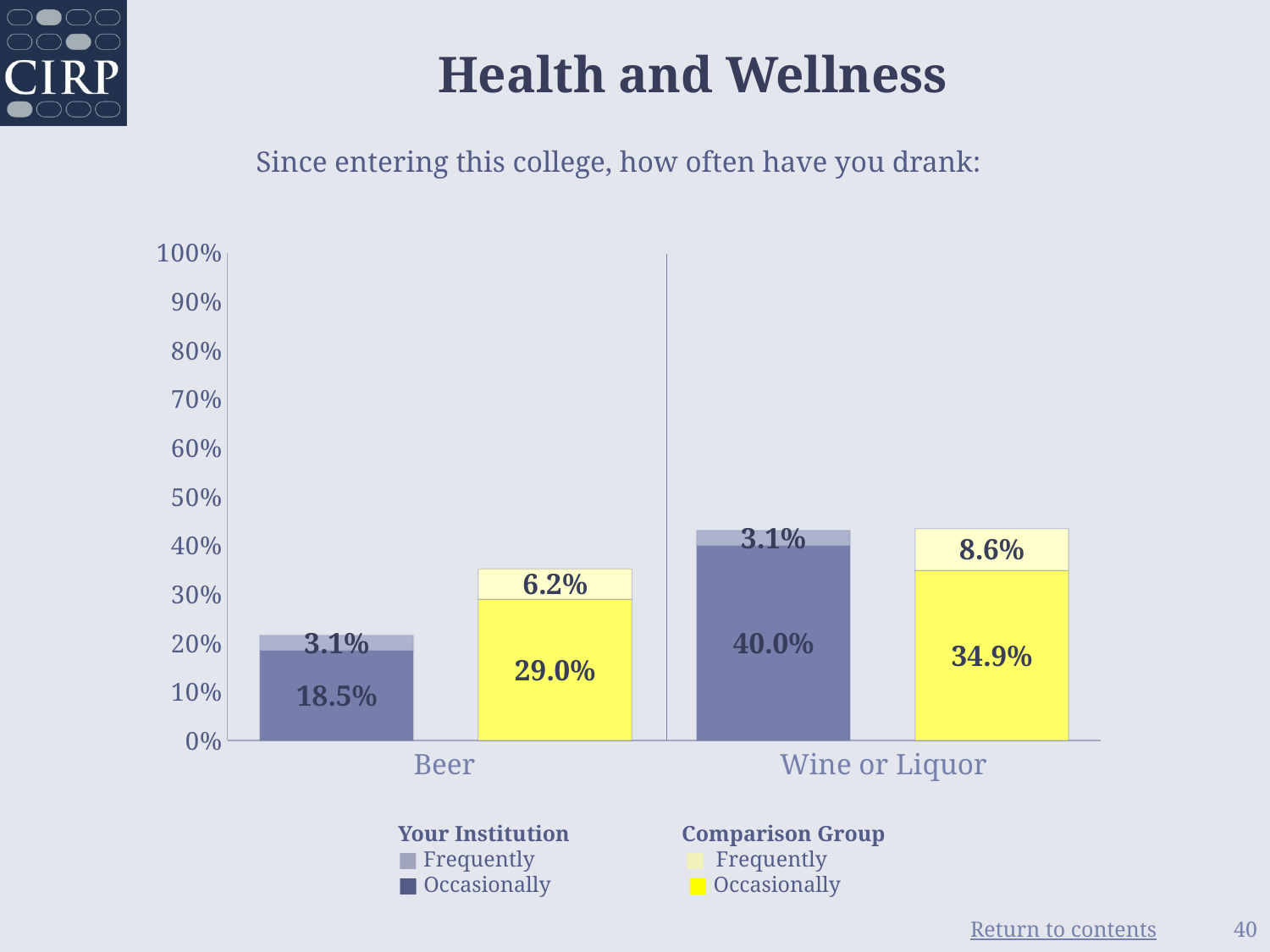
What percentage of the Comparison Group reported drinking wine or liquor frequently? 8.6% What percentage of students at Your Institution reported drinking beer occasionally? 18.5% What is the difference between the Comparison Group and Your Institution for drinking beer occasionally? 10.5% How many series does the legend list? 4 What is the total percentage of the Comparison Group who drank beer frequently or occasionally? 35.2% Which is larger for drinking wine or liquor occasionally: Your Institution or the Comparison Group? Your Institution What percentage of the Comparison Group reported drinking beer occasionally? 29.0% What percentage of students at Your Institution reported drinking wine or liquor occasionally? 40.0% Which is larger for drinking beer frequently: Your Institution or the Comparison Group? Comparison Group How many drink categories are shown on the x axis? 2 What is the total percentage of Your Institution students who drank beer frequently or occasionally? 21.6% What kind of chart is shown on the slide? Stacked bar chart